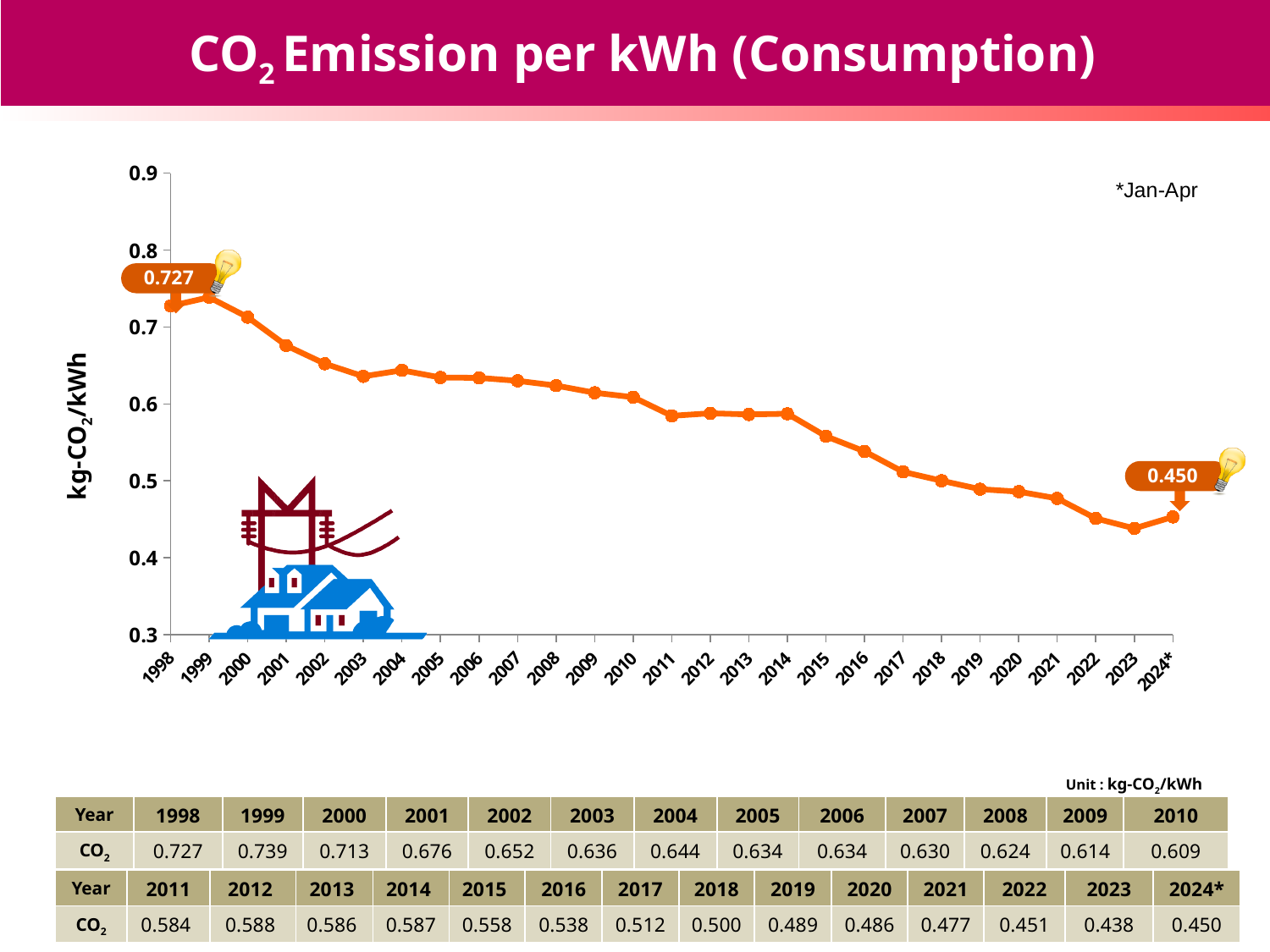
What is the CO2 emission per kWh value for 1998? 0.727 Which year has the lowest CO2 emission per kWh? 2023 What kind of chart is shown on the slide? line chart What is the CO2 emission per kWh value for 2024*? 0.450 What is the CO2 emission per kWh value for 2014? 0.587 Which year has the highest CO2 emission per kWh? 1999 Do the CO2 emission per kWh values generally rise or fall from 1998 to 2023? fall What is the difference between the CO2 emission per kWh in 1998 and in 2024*? 0.277 What is the unit shown on the y axis of the chart? kg-CO2/kWh Which year has a higher CO2 emission per kWh, 2010 or 2011? 2010 Is the value for 2016 greater or less than 0.5? greater How many years are plotted on the chart? 27